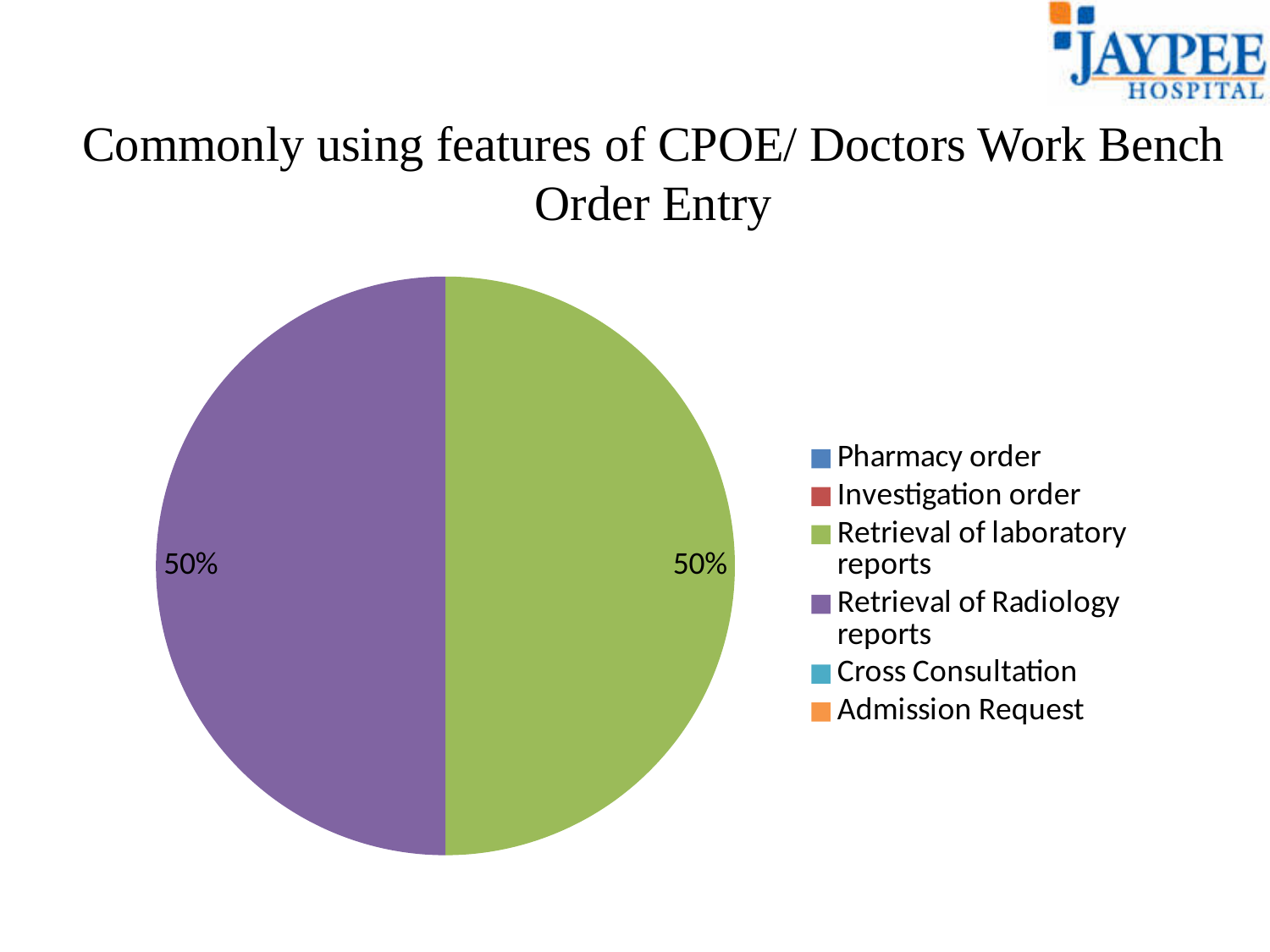
What share of the pie does Retrieval of laboratory reports have? 50% What is the combined share of the two visible slices? 100% How many entries does the legend list? 6 What share of the pie does Retrieval of Radiology reports have? 50% Which colour represents Retrieval of laboratory reports in the pie chart? Green Which legend entry is listed last? Admission Request How many slices are visible in the pie chart? 2 Which legend entry is listed first? Pharmacy order Which colour represents Retrieval of Radiology reports in the pie chart? Purple What is the difference between the shares for Retrieval of laboratory reports and Retrieval of Radiology reports? 0% What kind of chart is shown on the slide? Pie chart